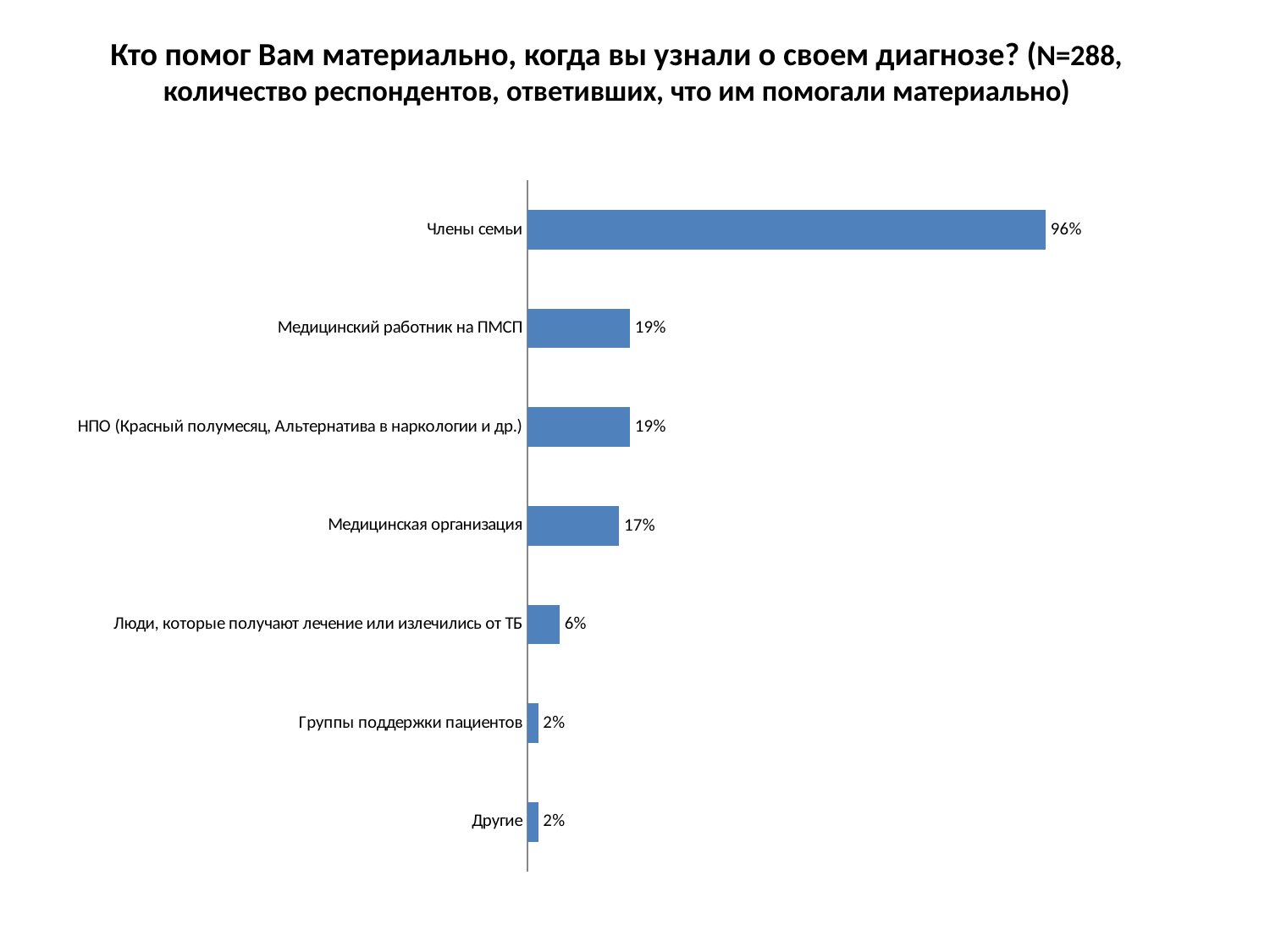
What is the value for Медицинская организация? 17% What is the sample size (N) stated in the chart title? 288 What is the value for Другие? 2% What kind of chart is shown on the slide? Bar chart What is the value for Люди, которые получают лечение или излечились от ТБ? 6% What is the value for Медицинский работник на ПМСП? 19% Which is larger, the value for Медицинская организация or the value for Люди, которые получают лечение или излечились от ТБ? Медицинская организация What is the difference between the values for Медицинская организация and Группы поддержки пациентов? 15% How many categories are shown in the chart? 7 Which category has the highest value? Члены семьи What is the value for Члены семьи? 96% What is the difference between the values for Члены семьи and Медицинский работник на ПМСП? 77%